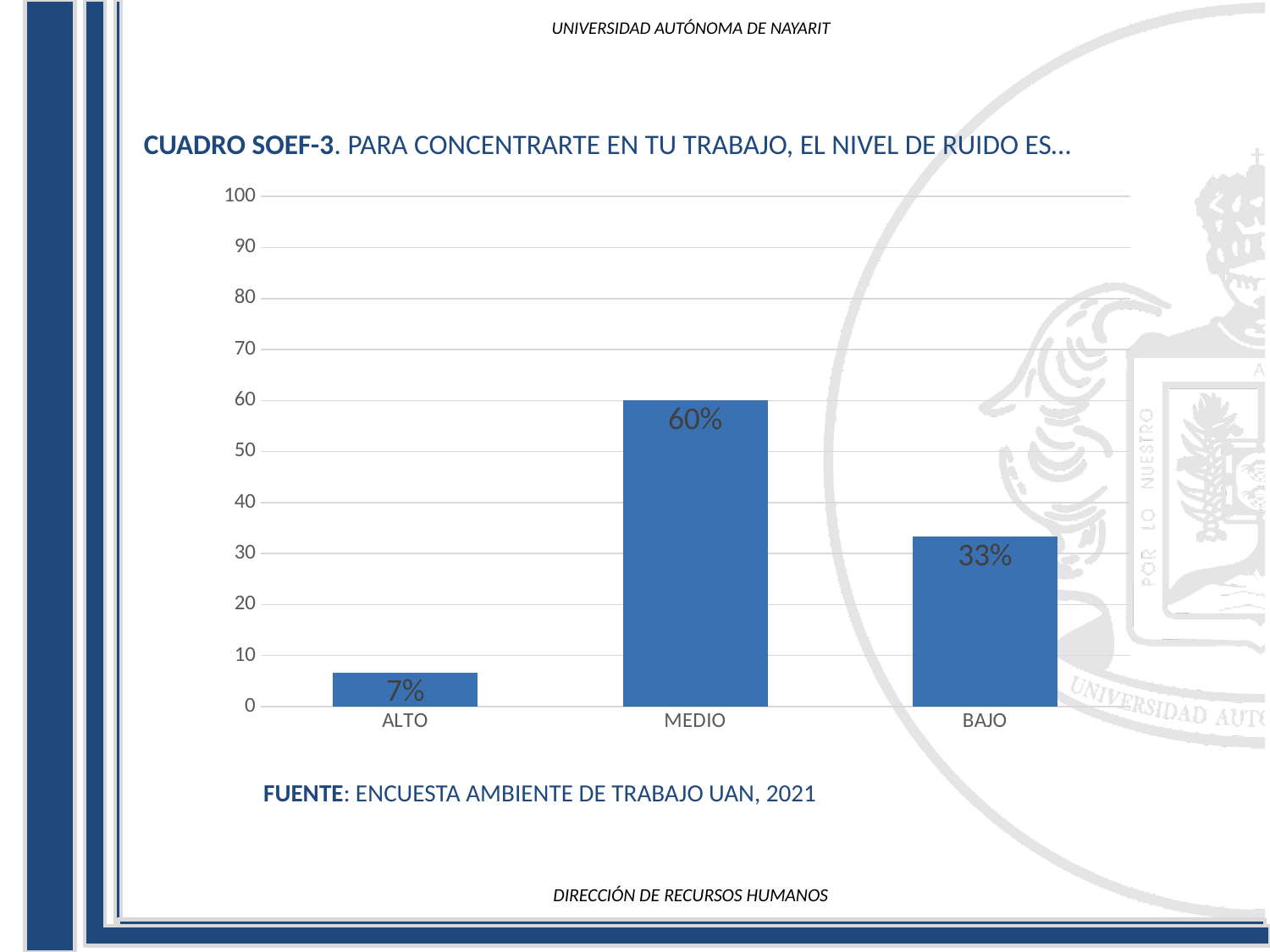
What is the difference between the values for BAJO and ALTO? 26% Which category has the lowest value? ALTO What is the value for BAJO? 33% What kind of chart is shown on the slide? bar chart How many categories are shown on the x axis? 3 Is the value for MEDIO greater or less than 50? greater What source is cited below the chart? ENCUESTA AMBIENTE DE TRABAJO UAN, 2021 Which category has the highest value? MEDIO What is the value for MEDIO? 60% What is the difference between the values for MEDIO and BAJO? 27% What is the value for ALTO? 7% Which is larger, the value for BAJO or the value for ALTO? BAJO